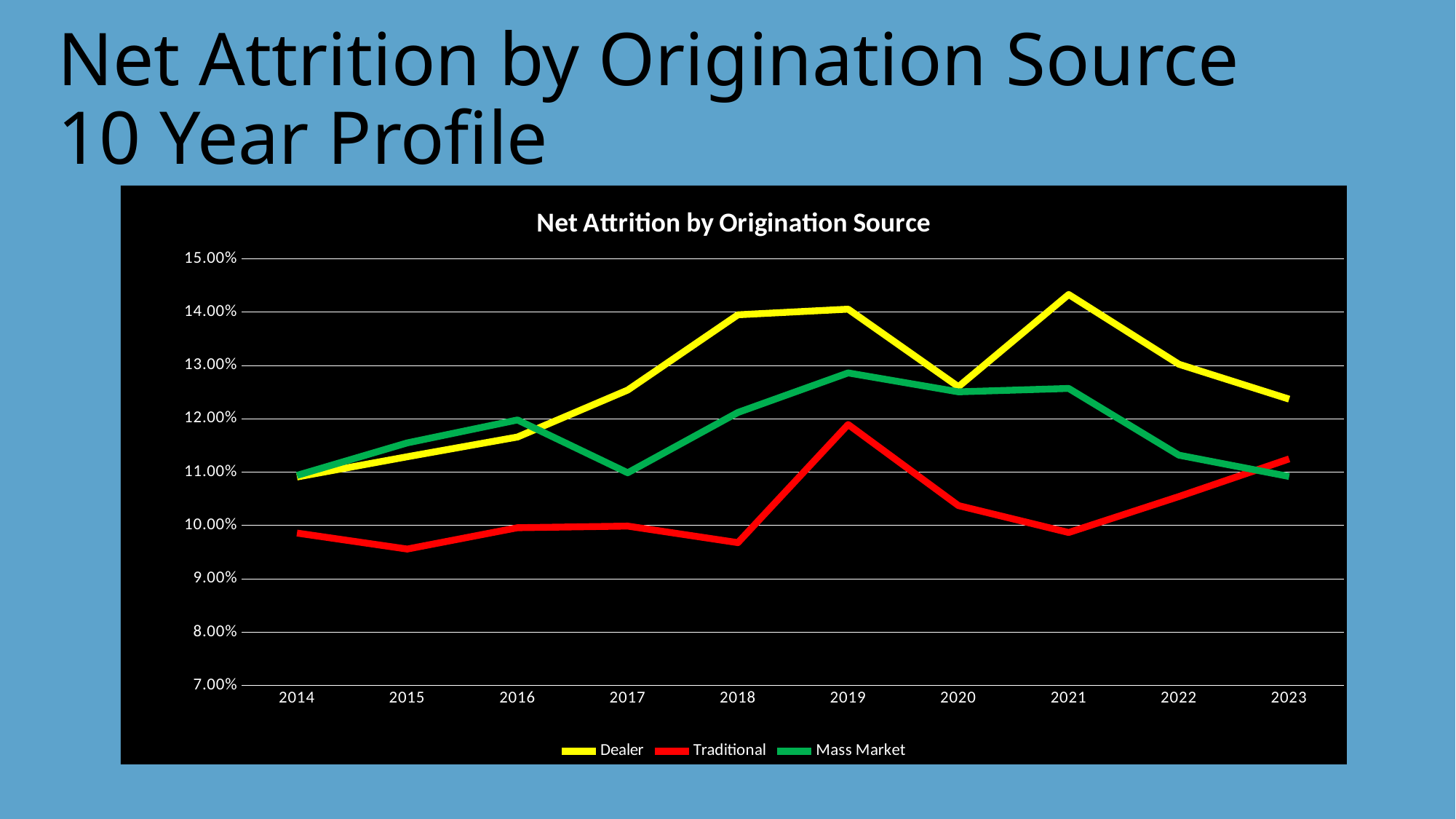
How many series does the legend list? 3 In 2016, which series has the higher value, Dealer or Mass Market? Mass Market Is the Traditional value for 2015 greater or less than 10.00%? less Does the Dealer series rise or fall from 2021 to 2023? fall In which year does the Traditional series reach its highest value? 2019 In which year does the Mass Market series reach its highest value? 2019 How many years are plotted along the x axis? 10 What kind of chart is shown on the slide? line chart Is the Mass Market value for 2017 greater or less than 12.00%? less What colour is the Traditional line? red Is the Dealer value for 2018 greater or less than 13.00%? greater In which year does the Dealer series reach its highest value? 2021